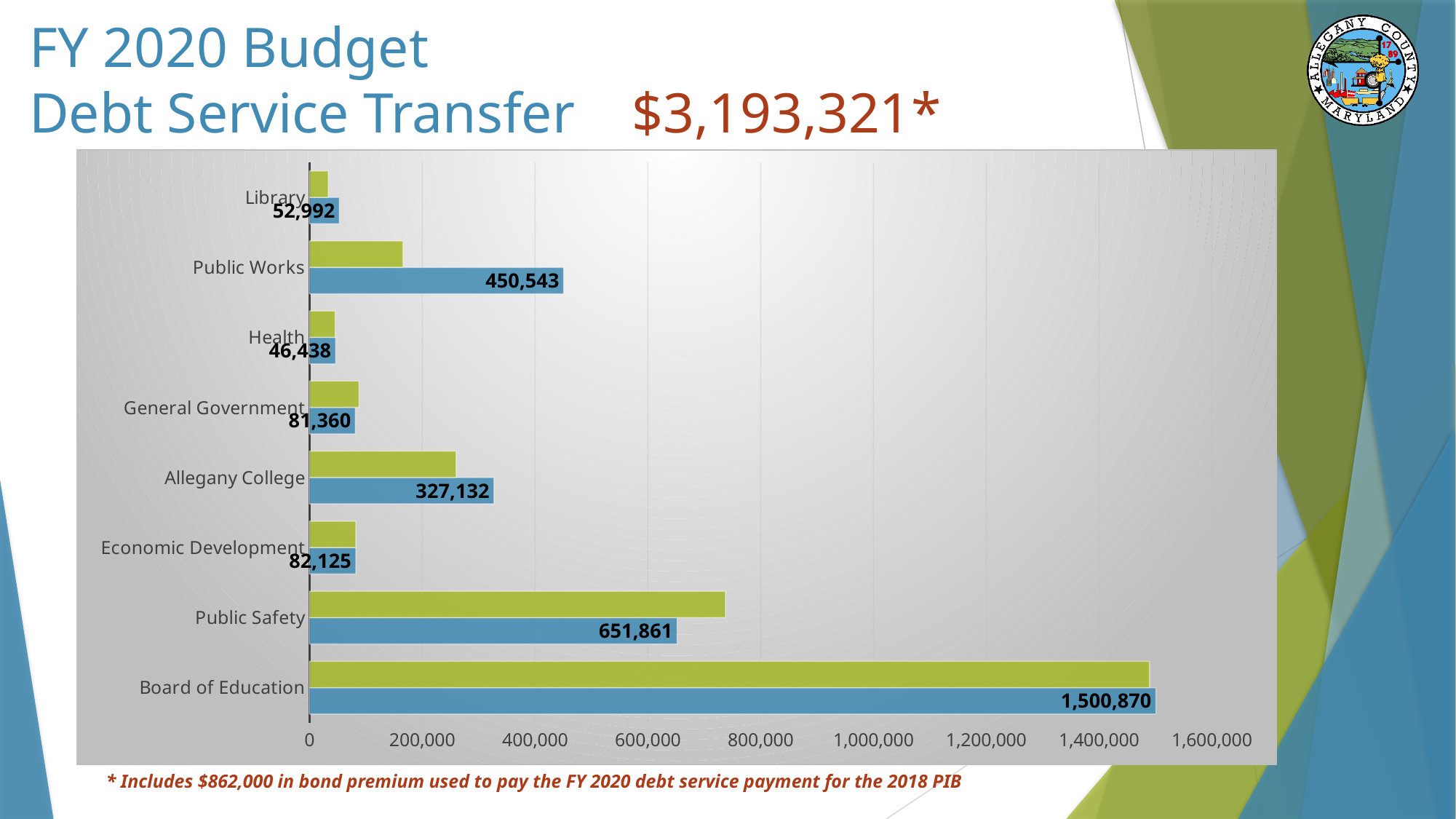
Is the value of the green bar for Public Safety greater or less than 600,000? greater What is the labeled value for Board of Education? 1,500,870 What total Debt Service Transfer amount is shown in the slide title? $3,193,321* What is the labeled value for Public Works? 450,543 What type of chart is shown on the slide? bar chart Which category has the lowest labeled value? Health Which has a larger labeled value, Economic Development or General Government? Economic Development What is the difference between the labeled values for Public Safety and Public Works? 201,318 What is the labeled value for Allegany College? 327,132 Which category has the highest labeled value? Board of Education How many categories are shown on the chart? 8 Is the value of the green bar for Public Works greater or less than 200,000? less